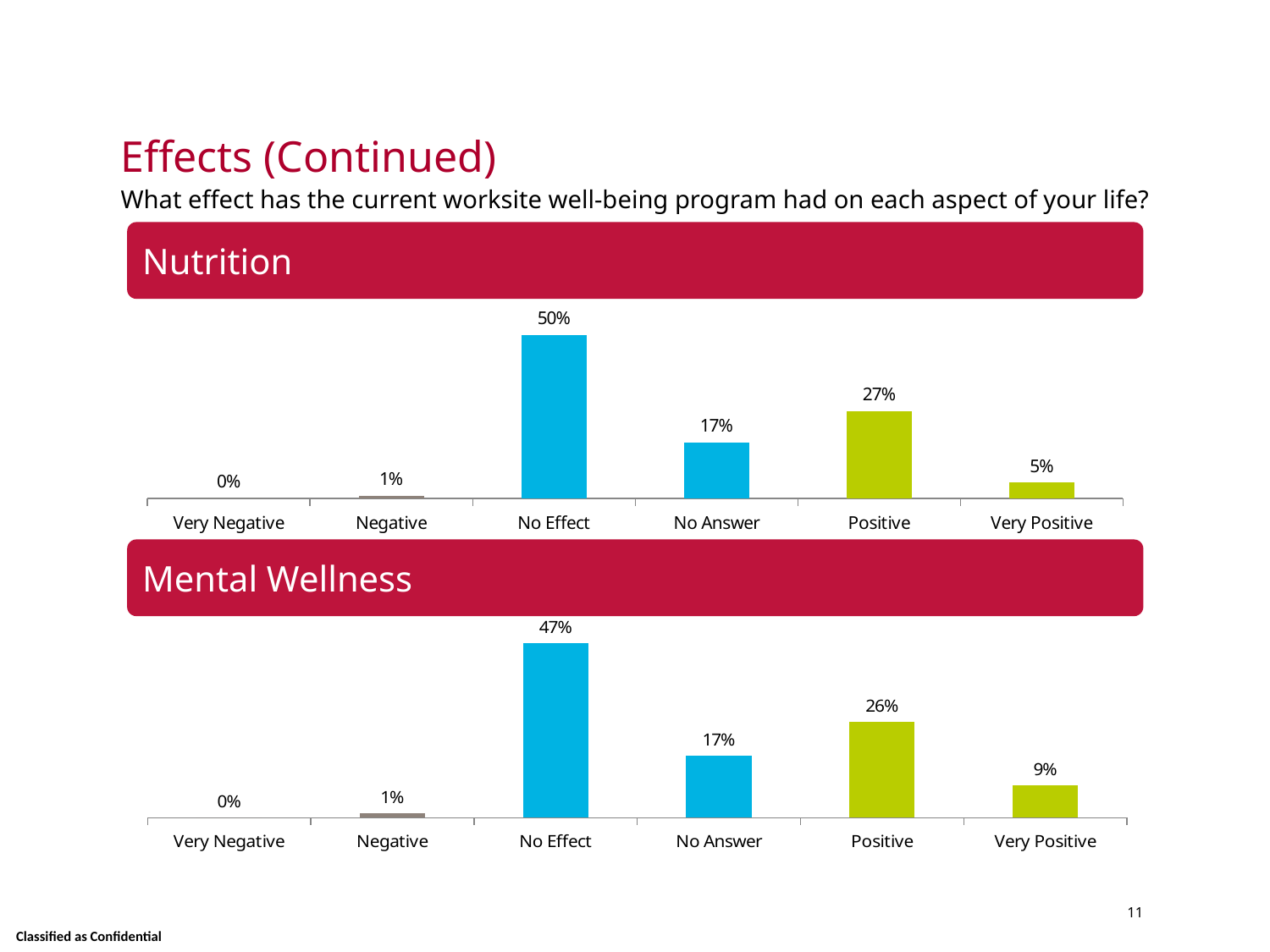
In the Nutrition chart, what is the value for Positive? 27% What is the title of the top chart on the slide? Nutrition In the Mental Wellness chart, what is the value for Very Positive? 9% In the Mental Wellness chart, which category has the highest value? No Effect In the Mental Wellness chart, which is larger, Positive or Very Positive? Positive What kind of chart is the Mental Wellness chart? Bar chart In the Nutrition chart, which category has the lowest value? Very Negative In the Nutrition chart, what is the value for No Effect? 50% How many charts are on the slide? 2 In the Mental Wellness chart, what is the difference between Positive and No Answer? 9% How many categories are shown in the Nutrition chart? 6 In the Nutrition chart, what is the difference between No Effect and Positive? 23%